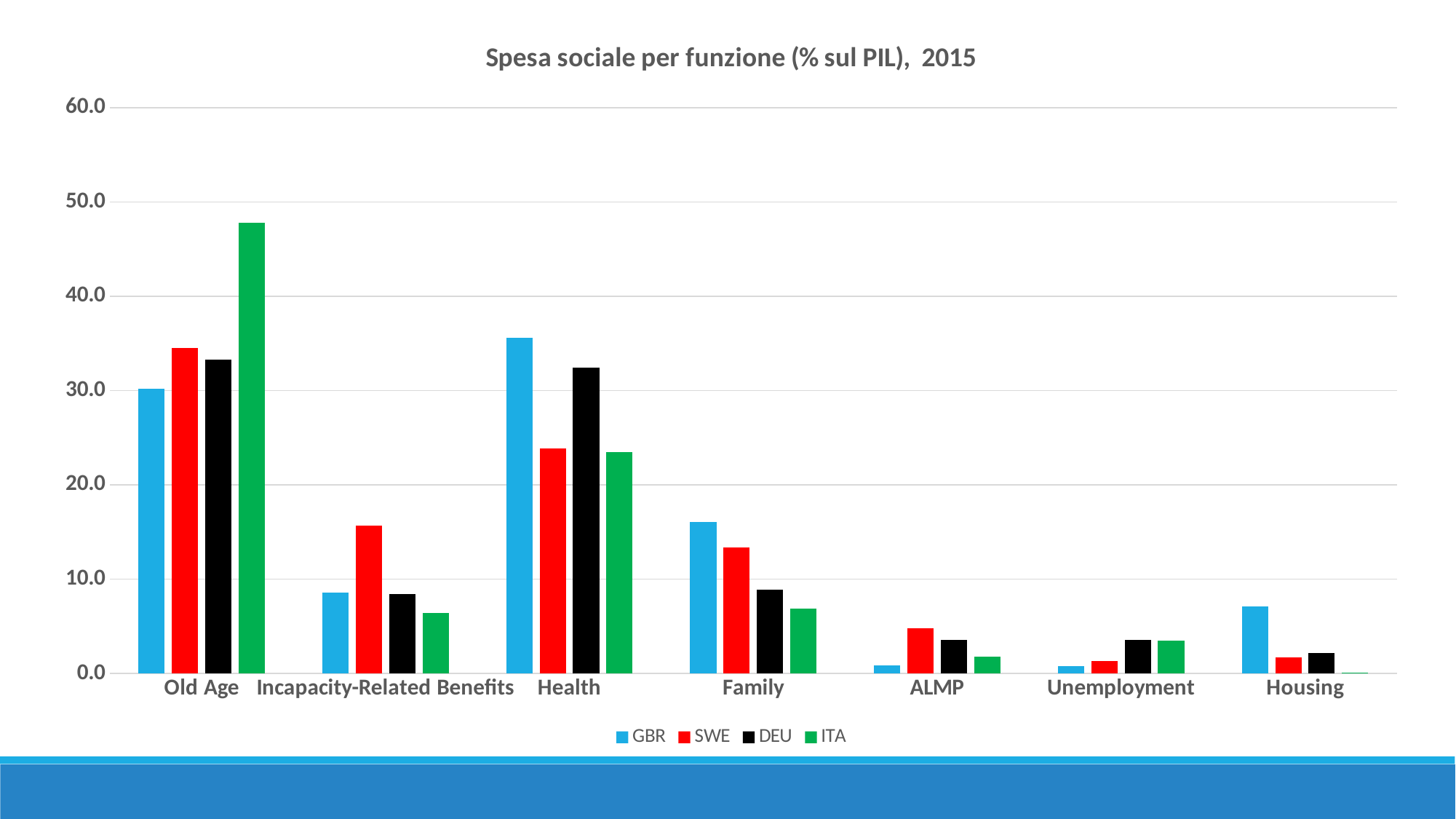
In the Health category, which is larger: the GBR bar or the SWE bar? GBR For which category is the ITA bar the highest? Old Age Which series has the highest value in the Family category? GBR What is the title of the chart? Spesa sociale per funzione (% sul PIL), 2015 In the Old Age category, which is larger: the SWE bar or the GBR bar? SWE How many categories are shown on the x axis? 7 How many series does the legend list? 4 Is the value for ITA in Old Age greater or less than 40.0? greater Is the value for GBR in Health greater or less than 30.0? greater Which series has the lowest value in the Housing category? ITA What kind of chart is shown on the slide? bar chart Is the value for SWE in Incapacity-Related Benefits greater or less than 10.0? greater